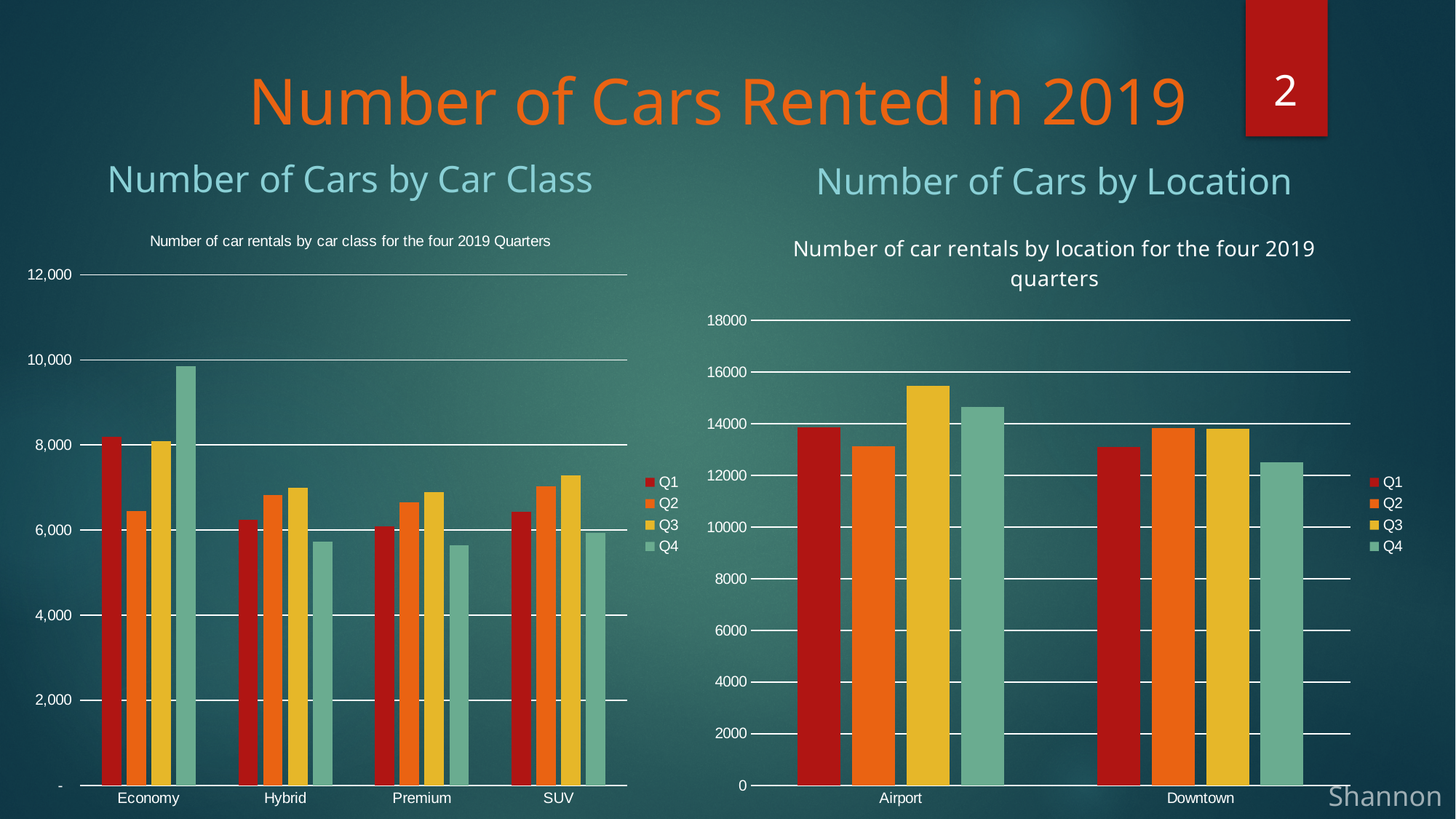
In the 'Number of car rentals by car class for the four 2019 Quarters' chart, what kind of chart is used? bar chart In the 'Number of car rentals by car class for the four 2019 Quarters' chart, which is larger for Economy, the Q1 value or the Q2 value? Q1 In the 'Number of car rentals by car class for the four 2019 Quarters' chart, is the Q4 value for Hybrid greater or less than 6,000? less In the 'Number of car rentals by location for the four 2019 quarters' chart, which quarter has the lowest value for Downtown? Q4 In the 'Number of car rentals by location for the four 2019 quarters' chart, how many locations are shown on the x axis? 2 In the 'Number of car rentals by location for the four 2019 quarters' chart, is the Q3 value for Airport greater or less than 14000? greater In the 'Number of car rentals by car class for the four 2019 Quarters' chart, which quarter has the highest value for Economy? Q4 In the 'Number of car rentals by car class for the four 2019 Quarters' chart, how many car classes are shown on the x axis? 4 In the 'Number of car rentals by car class for the four 2019 Quarters' chart, is the Q4 value for Economy greater or less than 8,000? greater In the 'Number of car rentals by car class for the four 2019 Quarters' chart, which quarter has the lowest value for Premium? Q4 In the 'Number of car rentals by location for the four 2019 quarters' chart, which quarter has the highest value for Airport? Q3 In the 'Number of car rentals by car class for the four 2019 Quarters' chart, how many series does the legend list? 4